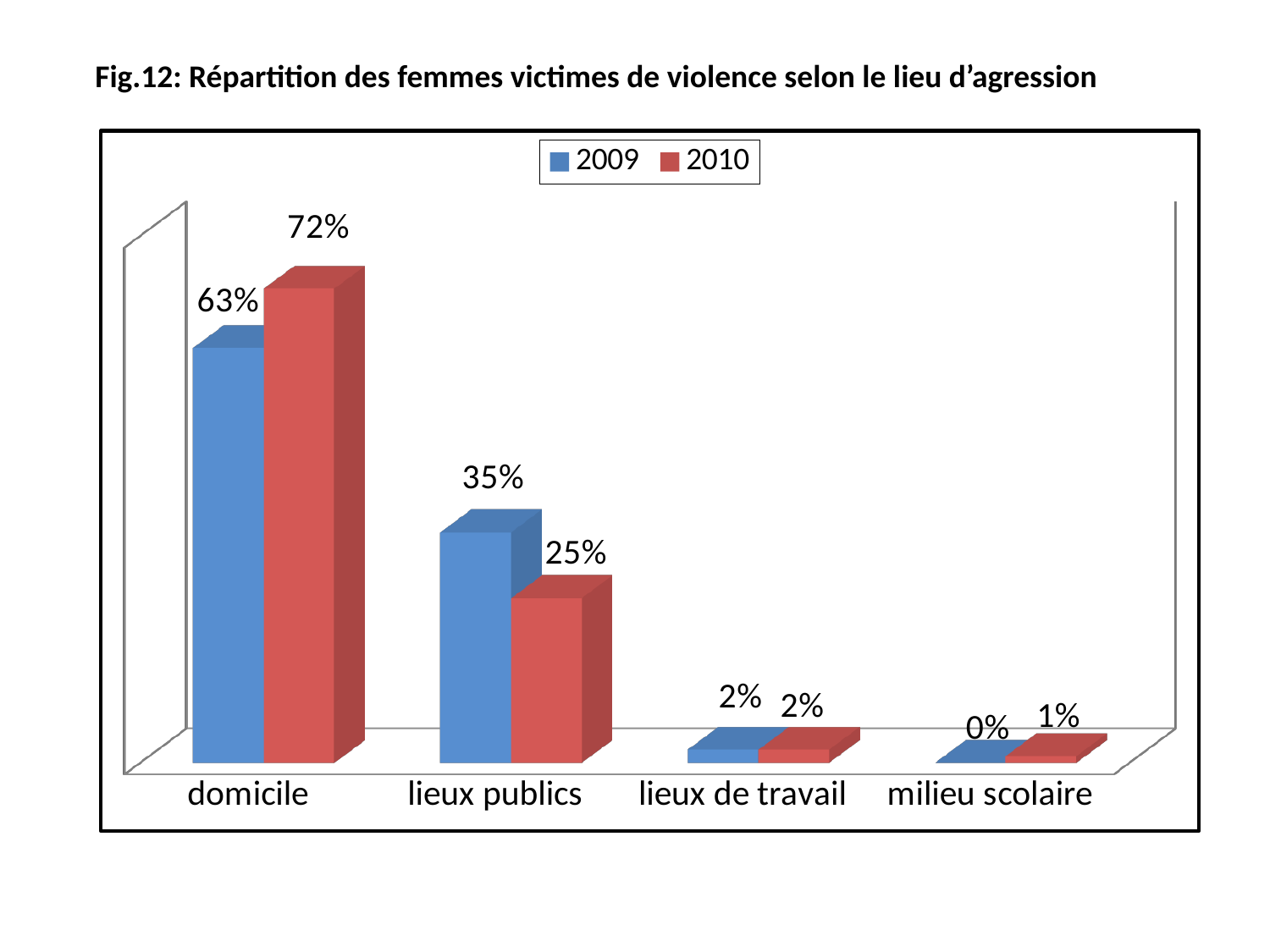
What is the value for domicile in 2010? 72% What kind of chart is shown on the slide? bar chart Which category has the highest value for 2010? domicile How many series does the legend list? 2 How many categories are shown on the x axis? 4 What is the value for milieu scolaire in 2009? 0% What is the difference between the 2009 and 2010 values for lieux publics? 10% What is the value for domicile in 2009? 63% Which is larger for lieux publics, the 2009 value or the 2010 value? 2009 Which category has the lowest value for 2009? milieu scolaire What is the value for lieux publics in 2010? 25% What is the difference between the 2010 and 2009 values for domicile? 9%